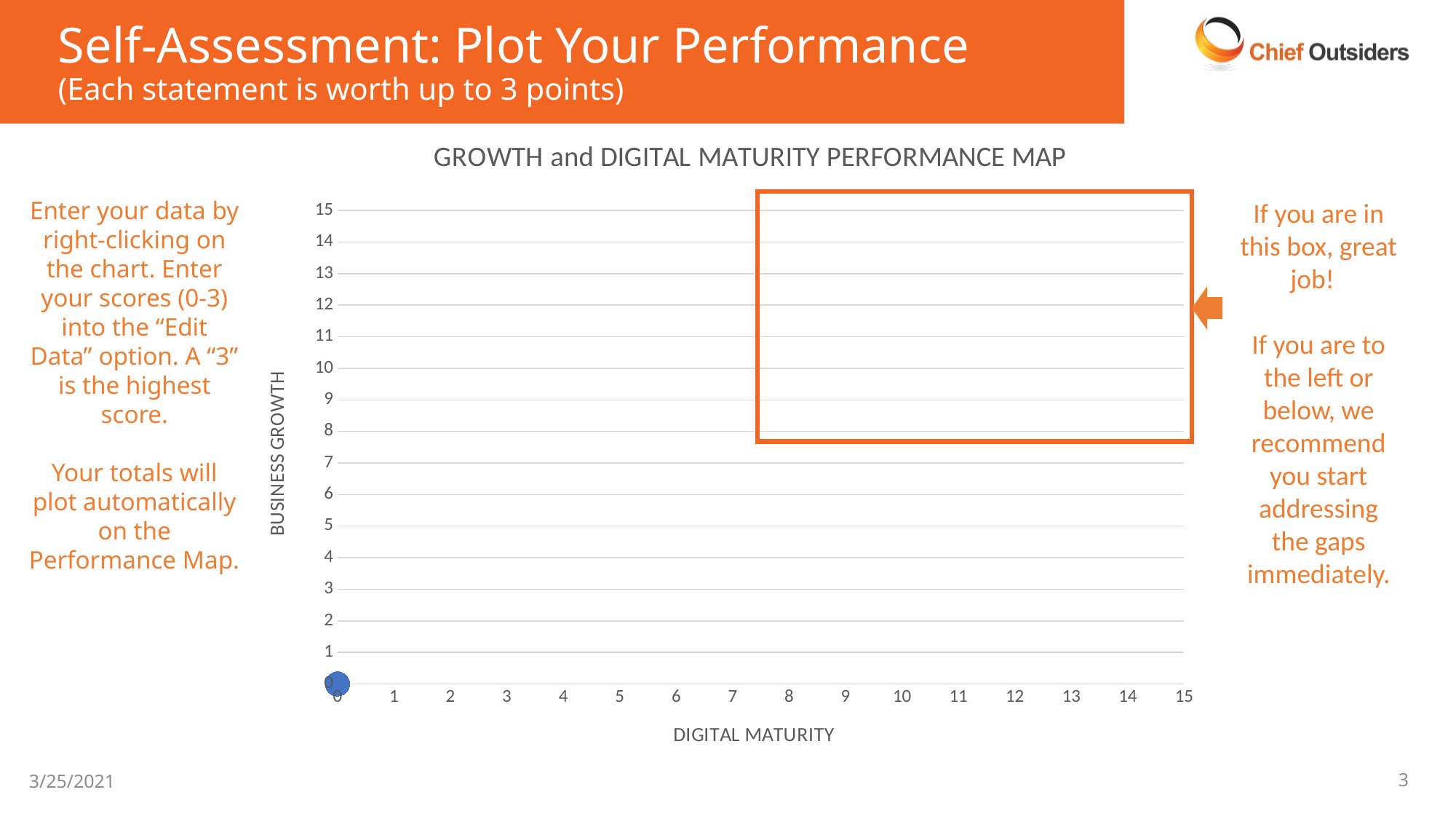
How many data points are plotted on the chart? 1 What is the DIGITAL MATURITY value of the plotted point? 0 Is the DIGITAL MATURITY value of the plotted point greater or less than 5? less What is the label of the vertical axis of the chart? BUSINESS GROWTH Is the BUSINESS GROWTH value of the plotted point greater or less than 10? less What is the highest value shown on the DIGITAL MATURITY axis? 15 What is the title of the chart? GROWTH and DIGITAL MATURITY PERFORMANCE MAP What is the BUSINESS GROWTH value of the plotted point? 0 What is the highest value shown on the BUSINESS GROWTH axis? 15 What kind of chart is shown on the slide? scatter chart